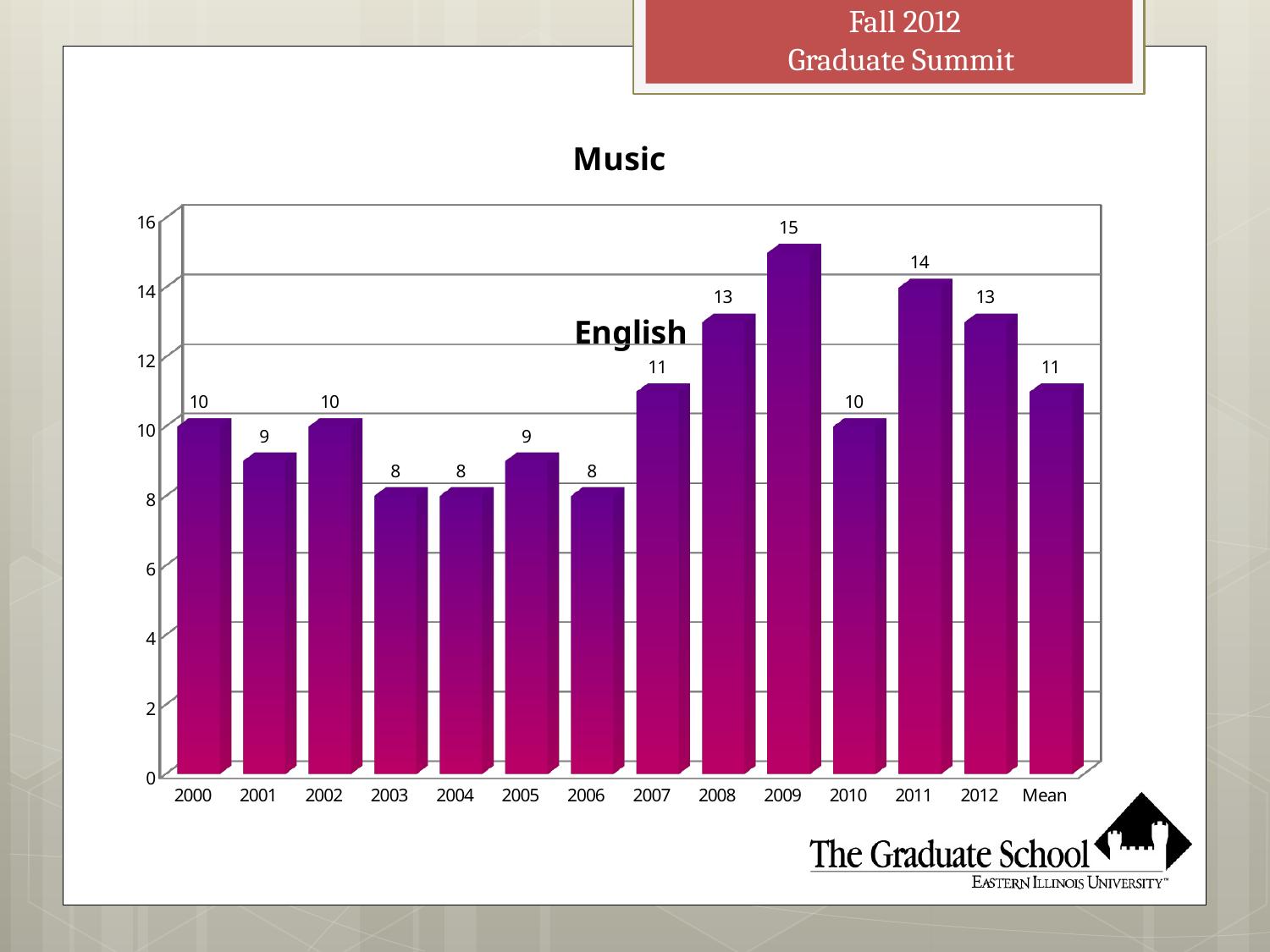
Which year has the highest value? 2009 What is the difference between the values for 2009 and 2010? 5 What is the value for 2011? 14 What is the value shown for Mean? 11 What is the value for 2003? 8 What is the value for 2009? 15 How many bars are plotted on the chart? 14 Do the values rise or fall from 2006 to 2009? Rise What kind of chart is shown on the slide? Bar chart What is the lowest value plotted on the chart? 8 What is the difference between the values for 2008 and 2001? 4 Which is larger, the value for 2007 or the value for 2005? 2007